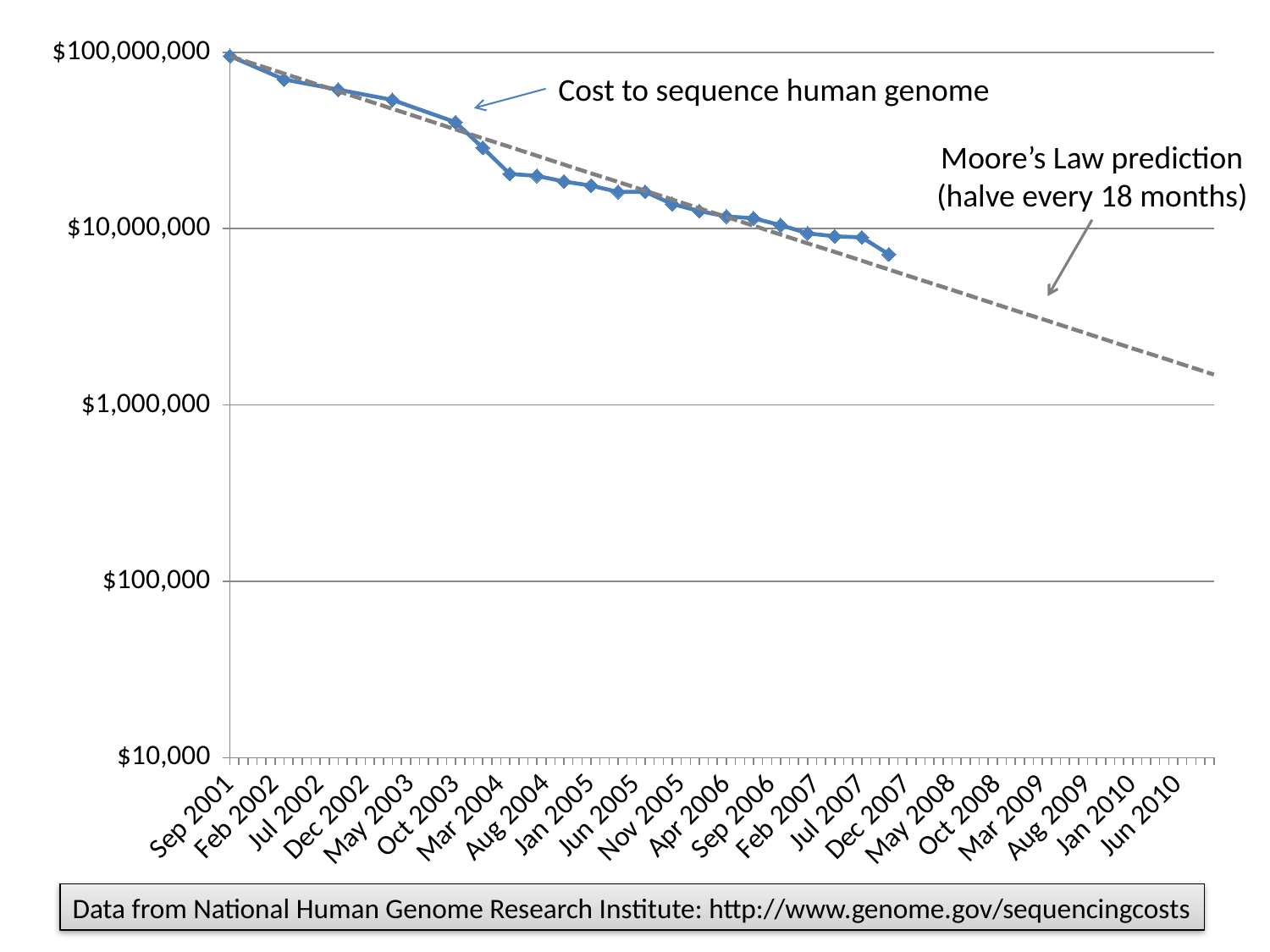
Which is larger: the cost to sequence a human genome in Sep 2001 or in Dec 2007? Sep 2001 Which date has the highest cost to sequence a human genome? Sep 2001 What kind of chart is shown on the slide? line chart What is the lowest value shown on the y axis? $10,000 Is the Moore's Law prediction at Jun 2010 greater or less than $10,000,000? less Is the cost to sequence a human genome at the last plotted point (Dec 2007) greater or less than $10,000,000? less Is the Moore's Law prediction at Jun 2010 greater or less than $1,000,000? greater What does the dashed line on the chart represent? Moore's Law prediction (halve every 18 months) How many lines are plotted on the chart? 2 Does the cost to sequence a human genome rise or fall over time along the x axis? fall